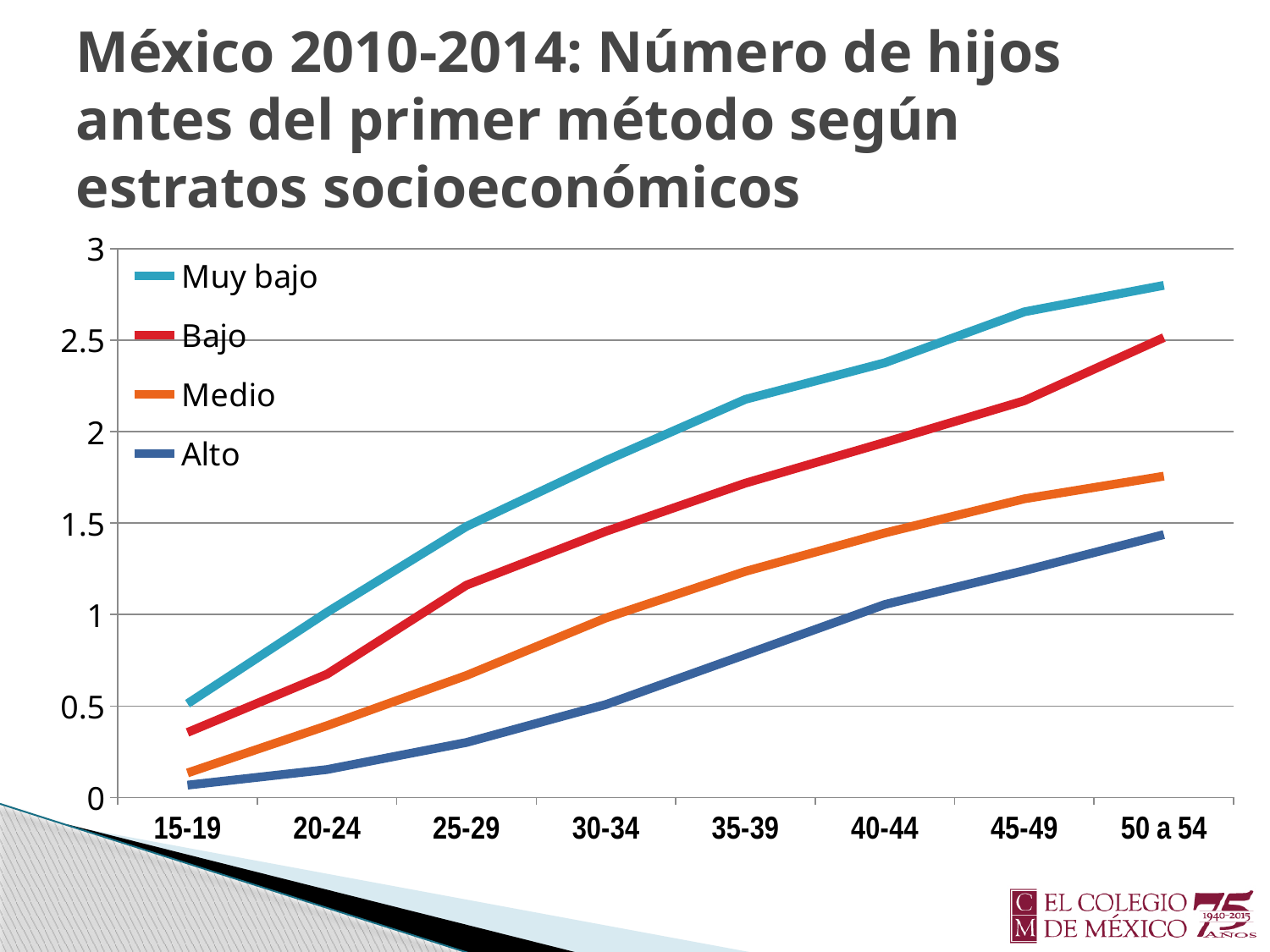
Is the value for Medio at 35-39 greater or less than 1? greater Which series has the lowest value at the 15-19 age group? Alto How many series does the legend list? 4 Is the value for Muy bajo at 50 a 54 greater or less than 2.5? greater Which series is drawn in red in the legend? Bajo What kind of chart is shown on the slide? line chart Do the values for the Alto series rise or fall as the age groups increase along the x axis? rise How many age groups are shown along the x axis? 8 Is the value for Alto at 15-19 greater or less than 0.5? less Which series has the highest value at the 50 a 54 age group? Muy bajo At the 30-34 age group, which is larger: the value for Muy bajo or the value for Alto? Muy bajo